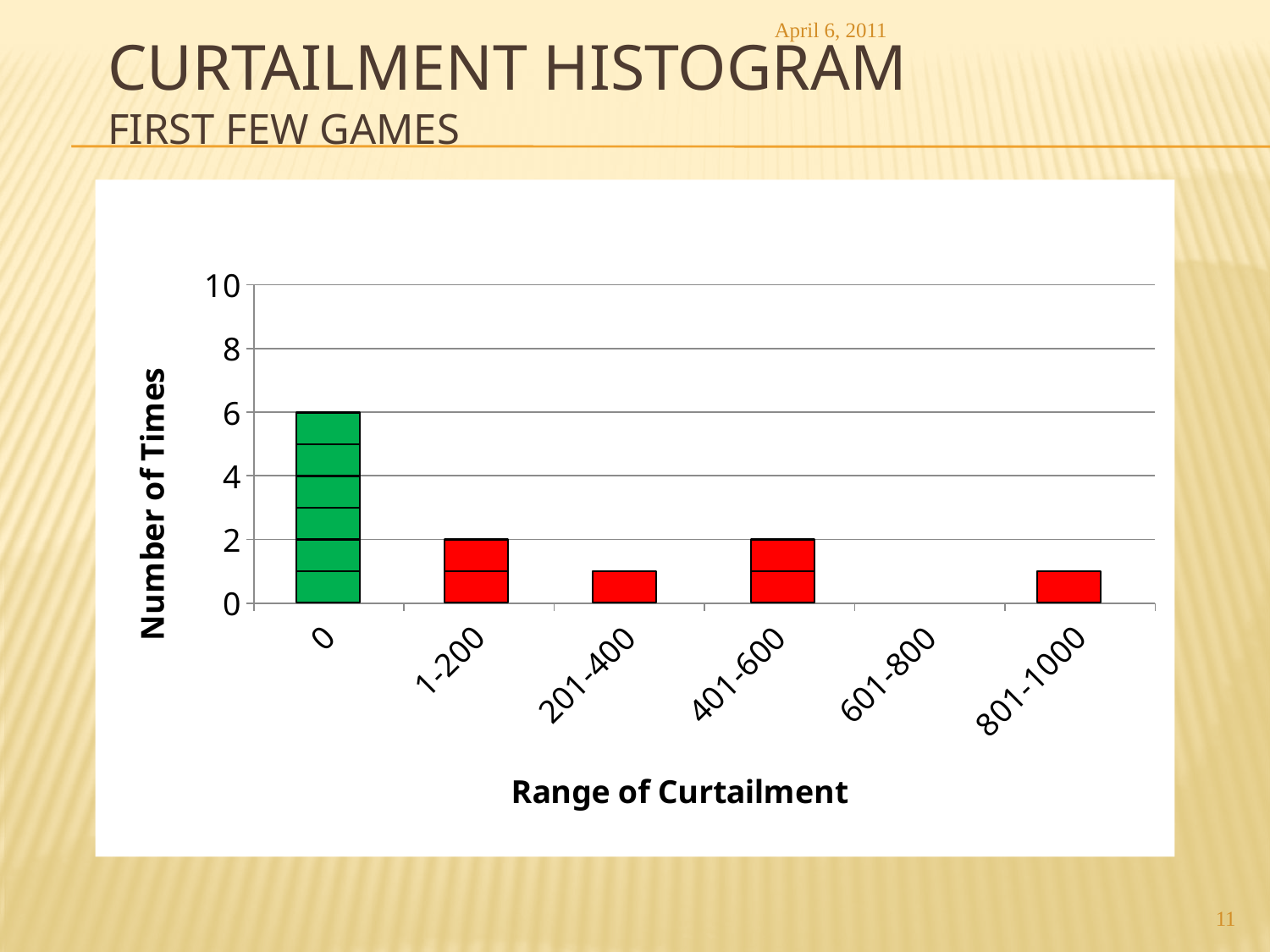
What type of chart is shown on the slide? bar chart Which has a larger number of times, the range 201-400 or the range 401-600? 401-600 What is the title of the y axis? Number of Times What is the number of times for the curtailment range 601-800? 0 What is the number of times for the curtailment range 0? 6 Is the number of times for the range 801-1000 greater or less than 2? less What is the number of times for the curtailment range 401-600? 2 Which curtailment range has the lowest number of times? 601-800 What is the difference in number of times between the range 0 and the range 1-200? 4 What is the number of times for the curtailment range 1-200? 2 Which curtailment range has the highest number of times? 0 How many curtailment ranges are shown on the x axis? 6